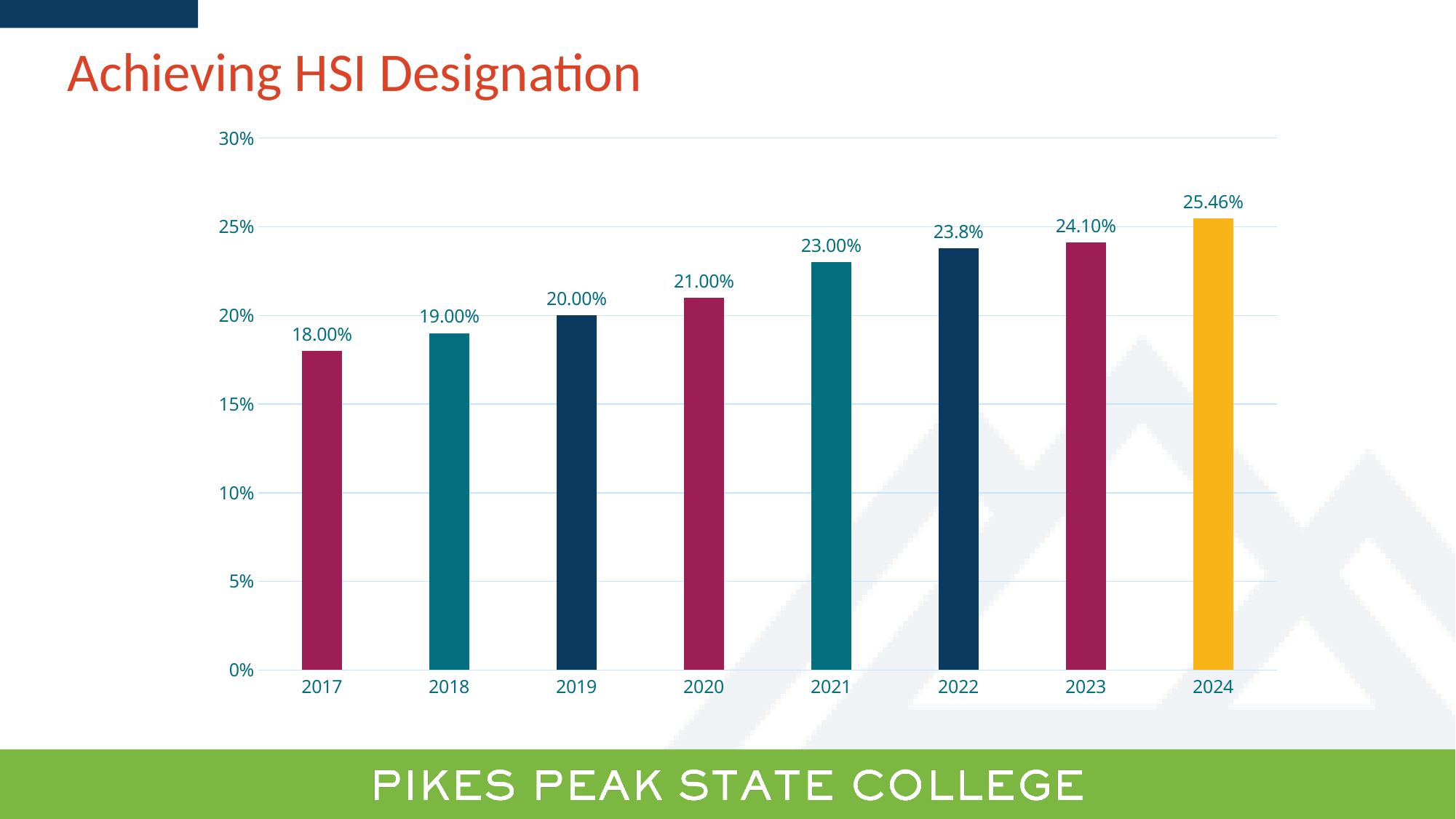
What is the difference between the values for 2023 and 2022? 0.3% How many years are shown on the x axis? 8 Do the values rise or fall from 2017 to 2024? rise What is the value for 2022? 23.8% Which year has the lowest value? 2017 What is the value for 2017? 18.00% Which is larger, the value for 2020 or the value for 2021? 2021 Is the value for 2024 greater or less than 25%? greater Which year has the highest value? 2024 What is the value for 2024? 25.46% What is the difference between the values for 2024 and 2017? 7.46% What kind of chart is shown on the slide? bar chart